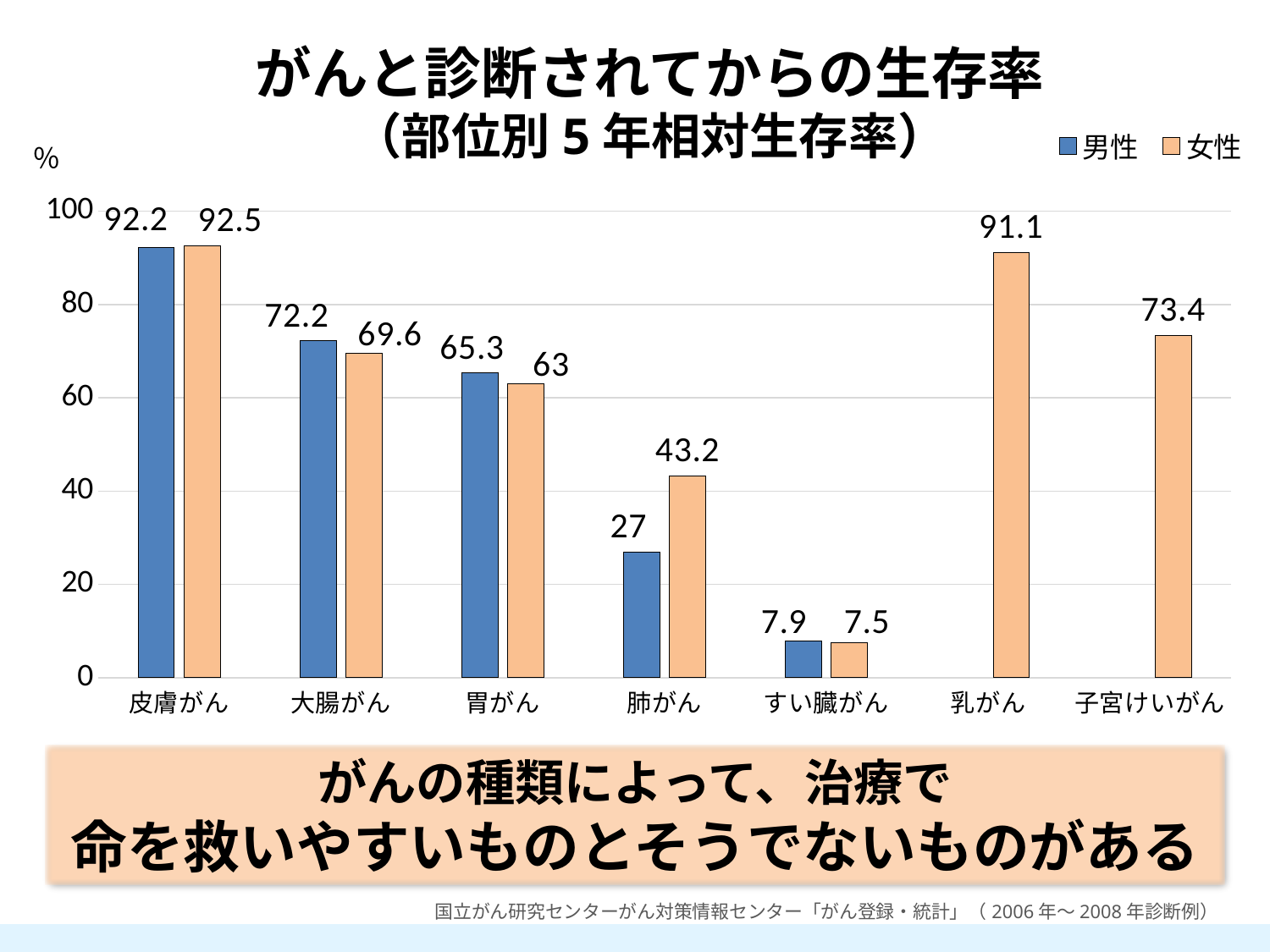
Which cancer type has the lowest survival rate for 男性? すい臓がん What kind of chart is shown on the slide? bar chart Which is larger for 胃がん, the 男性 value or the 女性 value? 男性 What is the difference between the 男性 and 女性 survival rates for 大腸がん? 2.6 What is the 5-year relative survival rate for 女性 with 肺がん? 43.2 How many cancer types are shown on the x axis? 7 How many series does the legend list? 2 What is the value for 女性 with 乳がん? 91.1 What is the 5-year relative survival rate for 男性 with 大腸がん? 72.2 Which colour represents 女性 in the chart? orange Which cancer type has the highest survival rate for 女性? 皮膚がん What is the difference between the 女性 and 男性 survival rates for 肺がん? 16.2